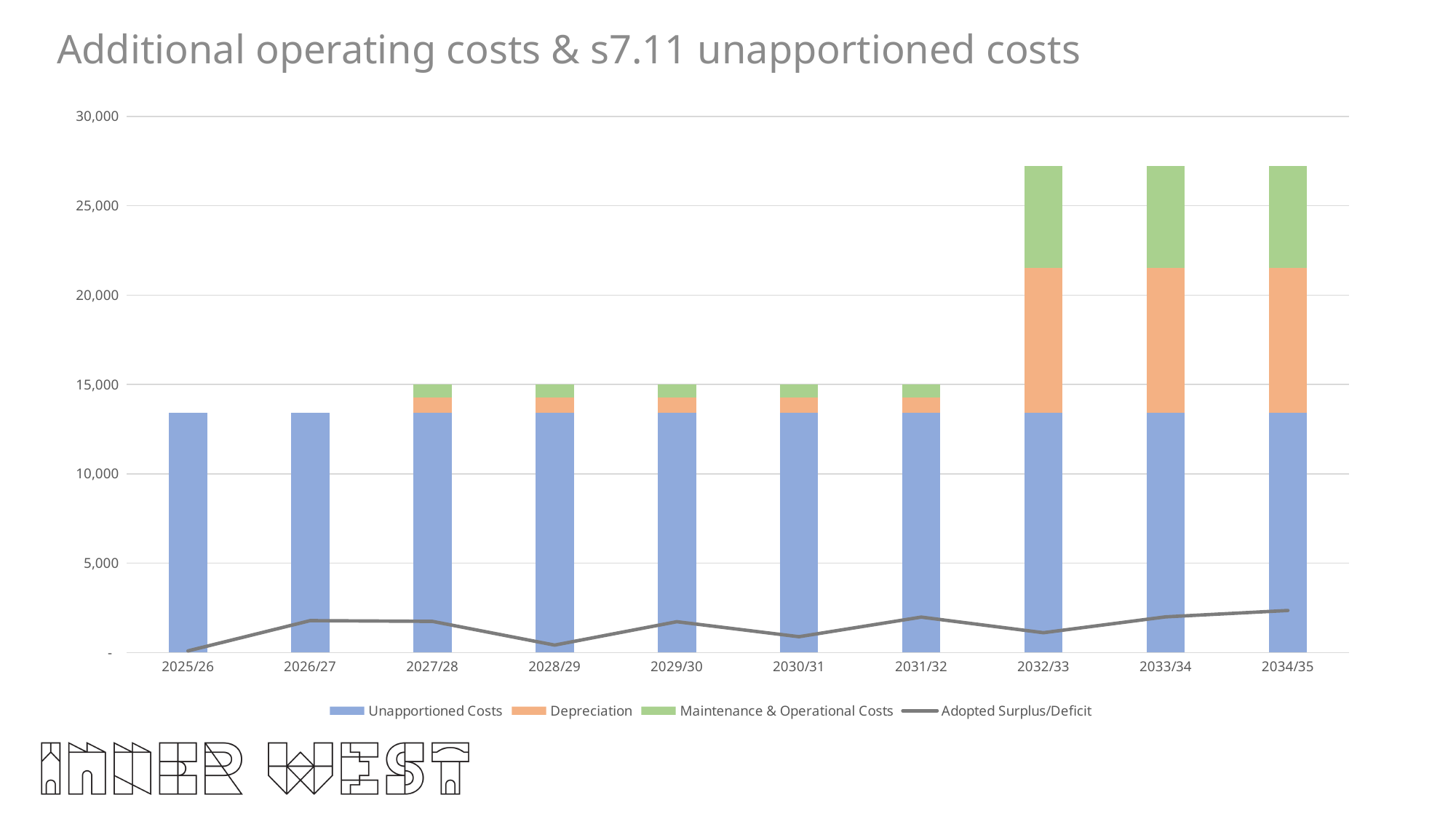
Which series is shown as a line rather than bars? Adopted Surplus/Deficit How many financial years are shown on the x axis? 10 In which year is the Adopted Surplus/Deficit line at its lowest? 2025/26 What kind of chart is shown on the slide? Stacked bar chart with a line How many series does the legend list? 4 Is the Unapportioned Costs value for 2025/26 greater or less than 10,000? greater Which year has the larger total stacked bar, 2025/26 or 2034/35? 2034/35 Is the total stacked bar for 2032/33 greater or less than 25,000? greater Which year has the larger Depreciation segment, 2027/28 or 2033/34? 2033/34 Is the Unapportioned Costs value for 2026/27 greater or less than 15,000? less Do the total stacked bar heights rise or fall from 2025/26 to 2034/35? rise